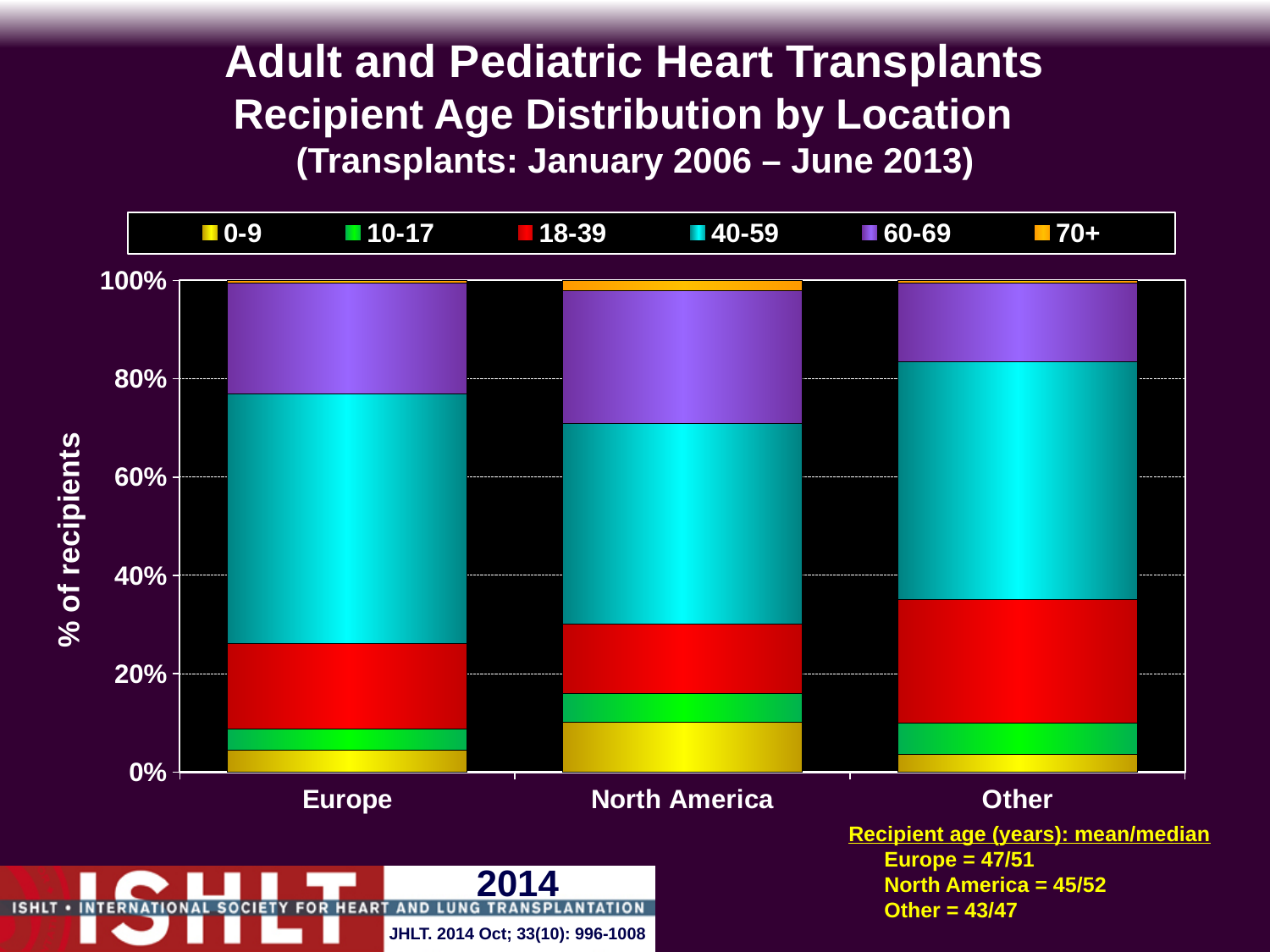
How many age groups does the legend list? 6 What is the label of the y axis? % of recipients Which location has the largest 0-9 age group share? North America Is the 40-59 share for Europe greater or less than 40%? greater How many locations are shown on the x axis of the chart? 3 Is the 0-9 share for North America greater or less than 20%? less What kind of chart is shown on the slide? Stacked bar chart Which location has the largest 60-69 age group share? North America What time period of transplants does the chart title cover? January 2006 – June 2013 Which location has the largest 18-39 age group share? Other Is the 0-9 share for Europe larger or smaller than the 0-9 share for North America? smaller